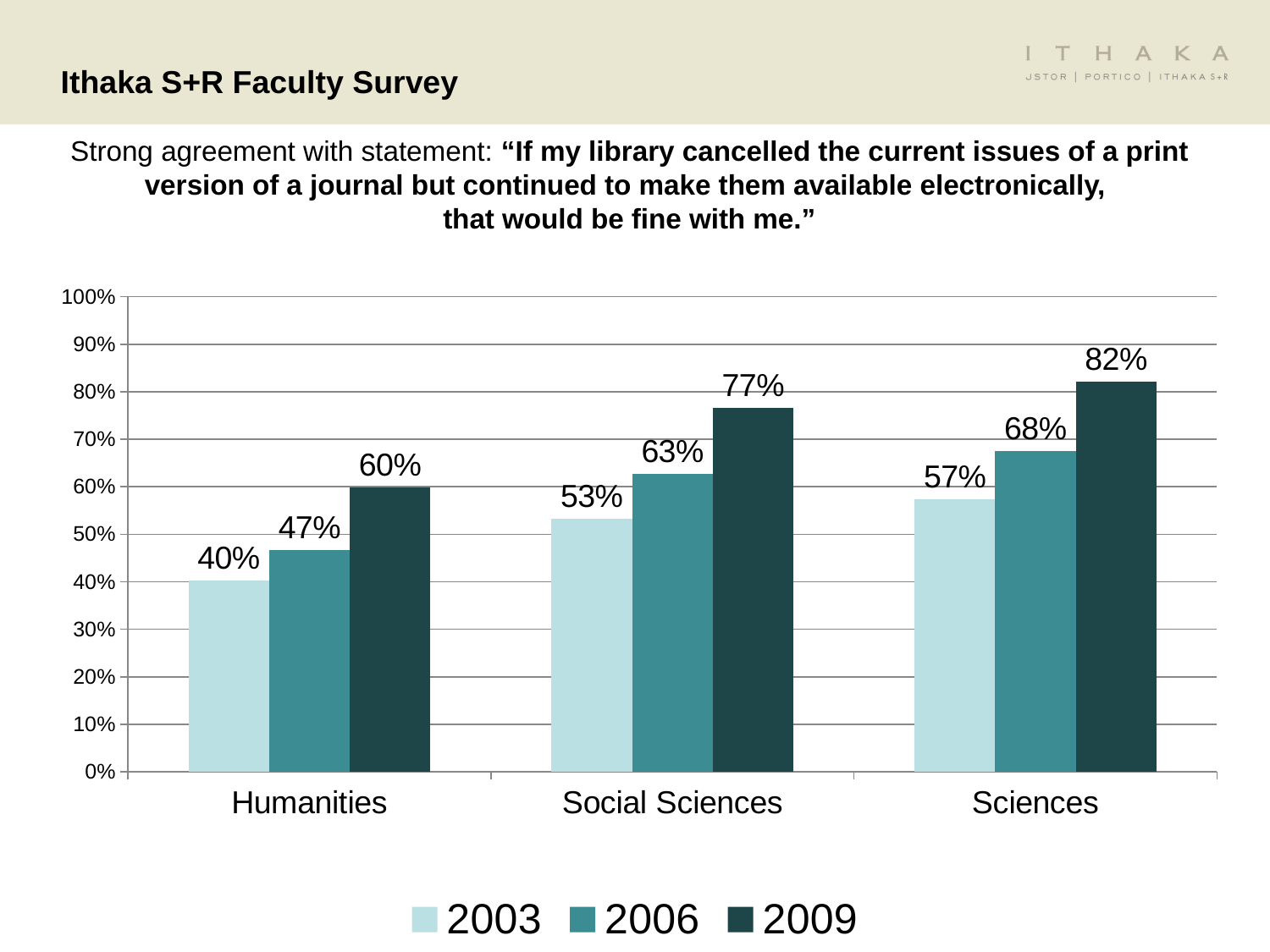
What is the difference between the 2009 and 2003 values for Sciences? 25% What is the difference between the Social Sciences and Humanities values in 2006? 16% What is the value for Humanities in 2003? 40% How many series does the legend list? 3 What is the value for Social Sciences in 2009? 77% What kind of chart is shown on the slide? Bar chart For Social Sciences, do the values rise or fall from 2003 to 2009? Rise Which discipline has the highest value in 2009? Sciences How many disciplines are shown on the x axis? 3 Which discipline has the lowest value in 2003? Humanities Which is larger: the 2009 value for Humanities or the 2003 value for Sciences? 2009 value for Humanities What is the value for Sciences in 2006? 68%